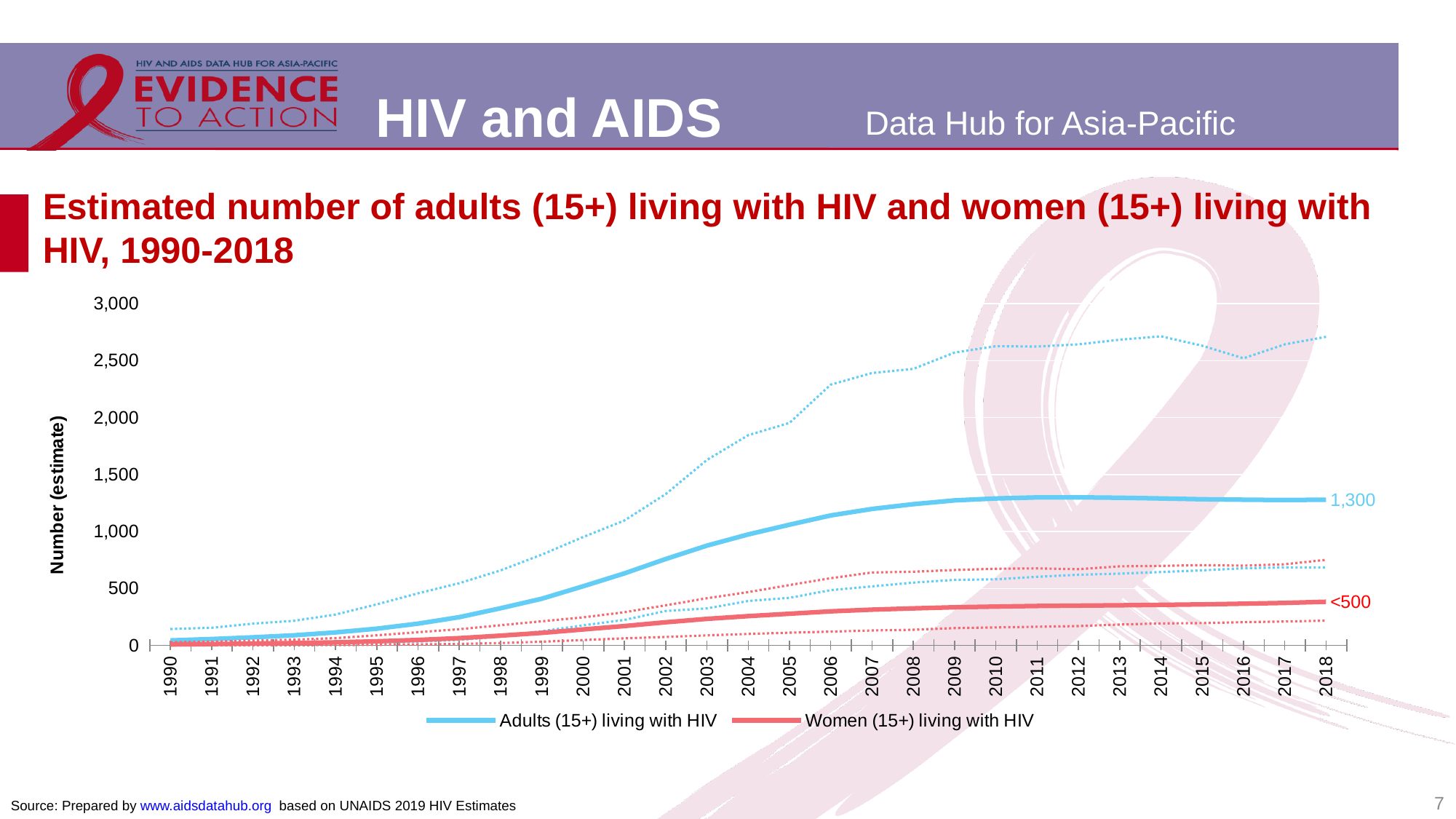
Is the value for Women (15+) living with HIV in 2010 greater or less than 500? less What is the labelled value for Adults (15+) living with HIV in 2018? 1,300 Is the value for Adults (15+) living with HIV in 2010 greater or less than 1,000? greater In 2018, which is larger: Adults (15+) living with HIV or Women (15+) living with HIV? Adults (15+) living with HIV How many years are shown on the x axis? 29 What kind of chart is shown on the slide? line chart What is the title of the y axis? Number (estimate) Does the Adults (15+) living with HIV series rise or fall from 1990 to 2018? rise What is the labelled value for Women (15+) living with HIV in 2018? <500 In which year is the Adults (15+) living with HIV series at its lowest? 1990 Which colour represents Women (15+) living with HIV in the legend? red How many series does the legend list? 2